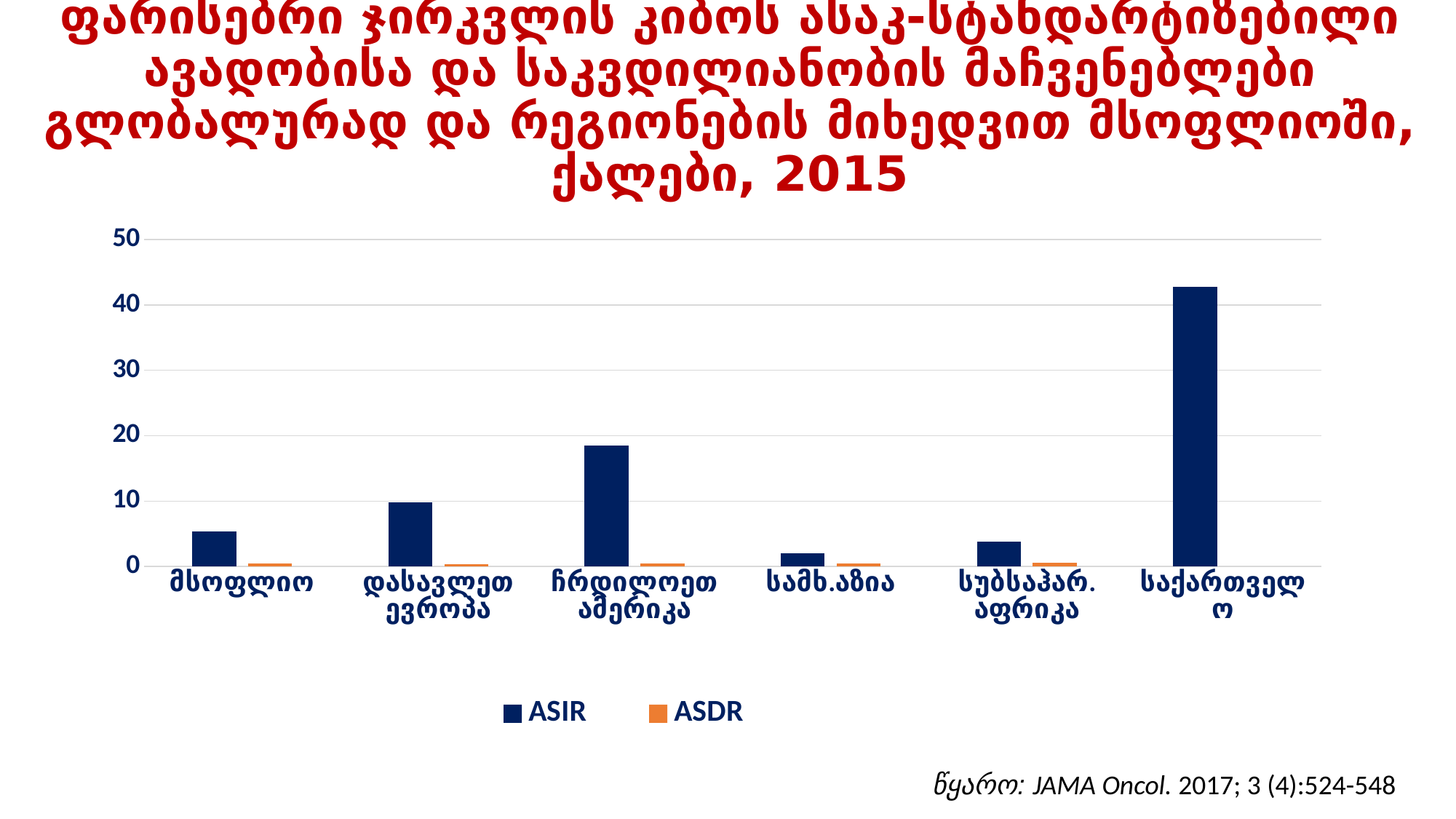
How many categories are shown on the x axis? 6 How many series does the legend list? 2 Which has the larger ASIR value, ჩრდილოეთ ამერიკა or დასავლეთ ევროპა? ჩრდილოეთ ამერიკა Which has the larger ASIR value, სუბსაჰარ. აფრიკა or სამხ.აზია? სუბსაჰარ. აფრიკა Which category has the lowest ASIR value? სამხ.აზია What colour are the ASDR bars? orange Is the ASIR value for საქართველო greater or less than 40? greater Which category has the highest ASIR value? საქართველო Is the ASIR value for მსოფლიო greater or less than 10? less Is the ASIR value for ჩრდილოეთ ამერიკა greater or less than 10? greater What kind of chart is shown on the slide? bar chart